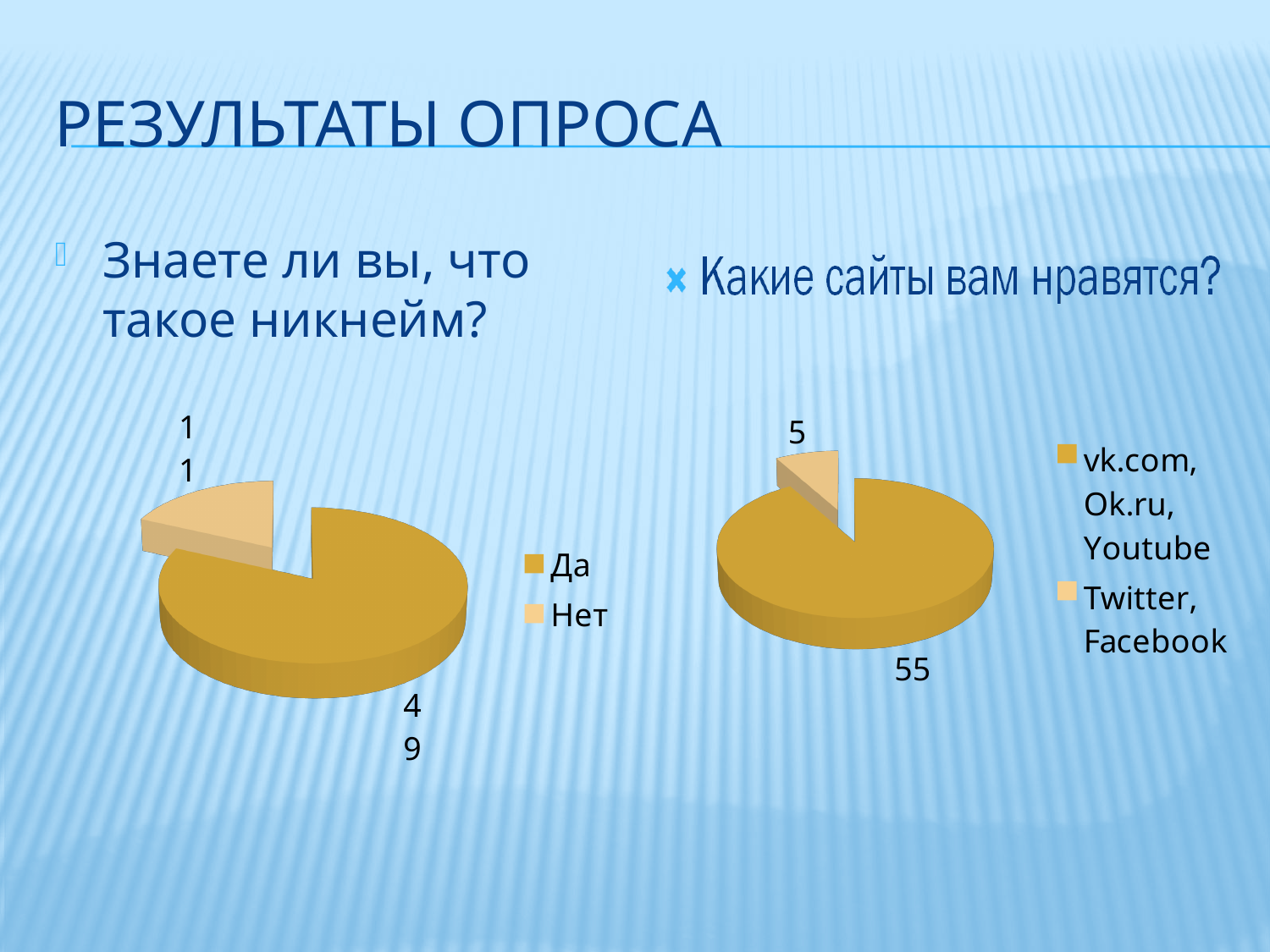
In the right chart (Какие сайты вам нравятся?), what is the value for Twitter, Facebook? 5 In the right chart (Какие сайты вам нравятся?), which category has the smallest slice? Twitter, Facebook In the left chart (Знаете ли вы, что такое никнейм?), what is the value for Да? 49 In the right chart (Какие сайты вам нравятся?), what is the value for vk.com, ok.ru, Youtube? 55 In the right chart (Какие сайты вам нравятся?), what is the difference between the values for vk.com, ok.ru, Youtube and Twitter, Facebook? 50 In the right chart (Какие сайты вам нравятся?), which is larger: vk.com, ok.ru, Youtube or Twitter, Facebook? vk.com, ok.ru, Youtube In the left chart (Знаете ли вы, что такое никнейм?), what is the difference between the values for Да and Нет? 38 How many slices does the left chart (Знаете ли вы, что такое никнейм?) have? 2 What are the legend entries of the right chart (Какие сайты вам нравятся?)? vk.com, Ok.ru, Youtube; Twitter, Facebook What type of chart is the right chart (Какие сайты вам нравятся?)? Pie chart In the left chart (Знаете ли вы, что такое никнейм?), what is the value for Нет? 11 In the left chart (Знаете ли вы, что такое никнейм?), which category has the largest slice? Да